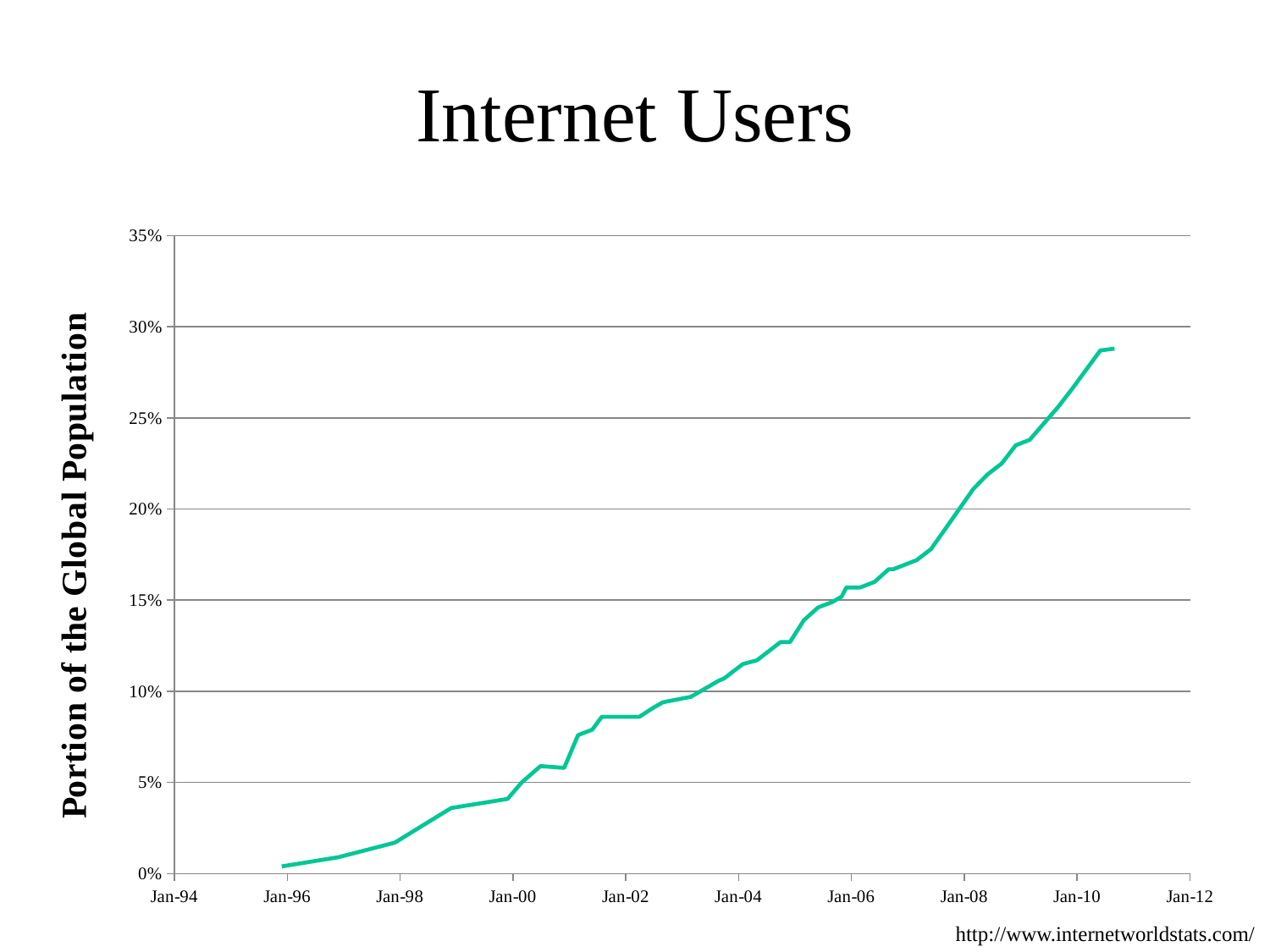
Is the value at Jan-02 greater or less than 10%? less What is the label on the vertical axis of the chart? Portion of the Global Population Is the value at Jan-10 greater or less than 25%? greater Is the value at Jan-00 greater or less than 5%? less What is the highest value shown on the vertical axis? 35% What is the title of the chart? Internet Users Is the value at Jan-04 larger or smaller than the value at Jan-08? smaller What kind of chart is shown on the slide? line chart How many year labels are shown along the horizontal axis? 10 Do the values in the chart generally rise or fall from Jan-96 to Jan-10? rise